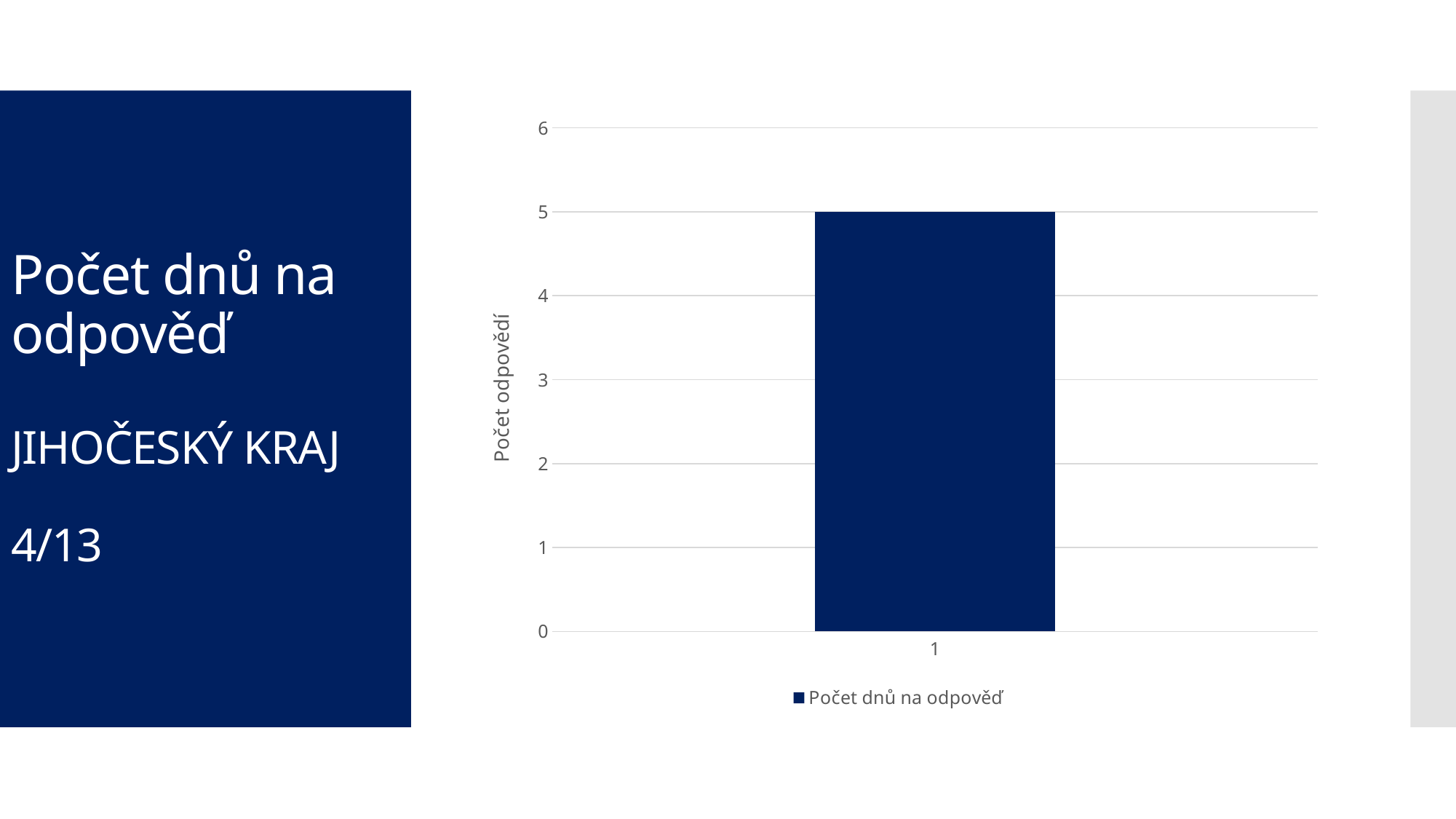
What is the highest value shown on the vertical axis? 6 What is the value of the bar for category 1? 5 How many series does the legend list? 1 What is the name of the series shown in the legend? Počet dnů na odpověď How many bars are plotted in the chart? 1 What kind of chart is shown on the slide? bar chart Is the value for category 1 greater or less than 6? less What is the category label shown on the horizontal axis? 1 What is the title of the vertical axis? Počet odpovědí Is the value for category 1 greater or less than 4? greater